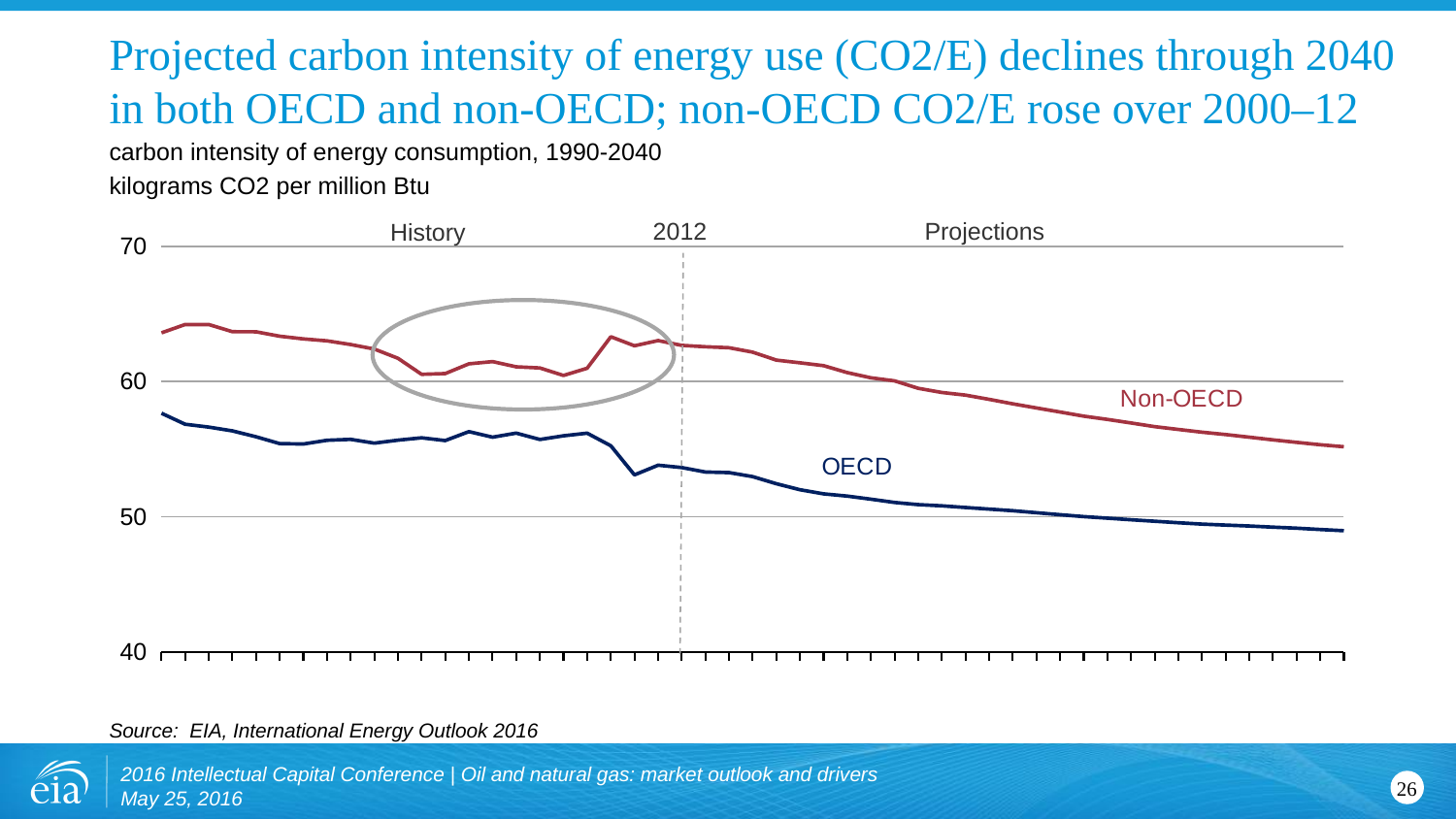
Which series is higher throughout the entire chart, Non-OECD or OECD? Non-OECD How many series are plotted on the chart? 2 Which series has the higher carbon intensity at the 2012 marker, Non-OECD or OECD? Non-OECD Do the Non-OECD and OECD lines rise or fall over the projection period after 2012? fall What year does the dashed vertical line separating History from Projections mark? 2012 Is the Non-OECD value at the end of the projection period (2040) greater or less than 50? greater Is the OECD value at the 2012 marker greater or less than 50? greater What unit is the chart's y axis measured in, according to the subtitle? kilograms CO2 per million Btu Is the Non-OECD value at the 2012 marker greater or less than 60? greater What kind of chart is shown on the slide? line chart